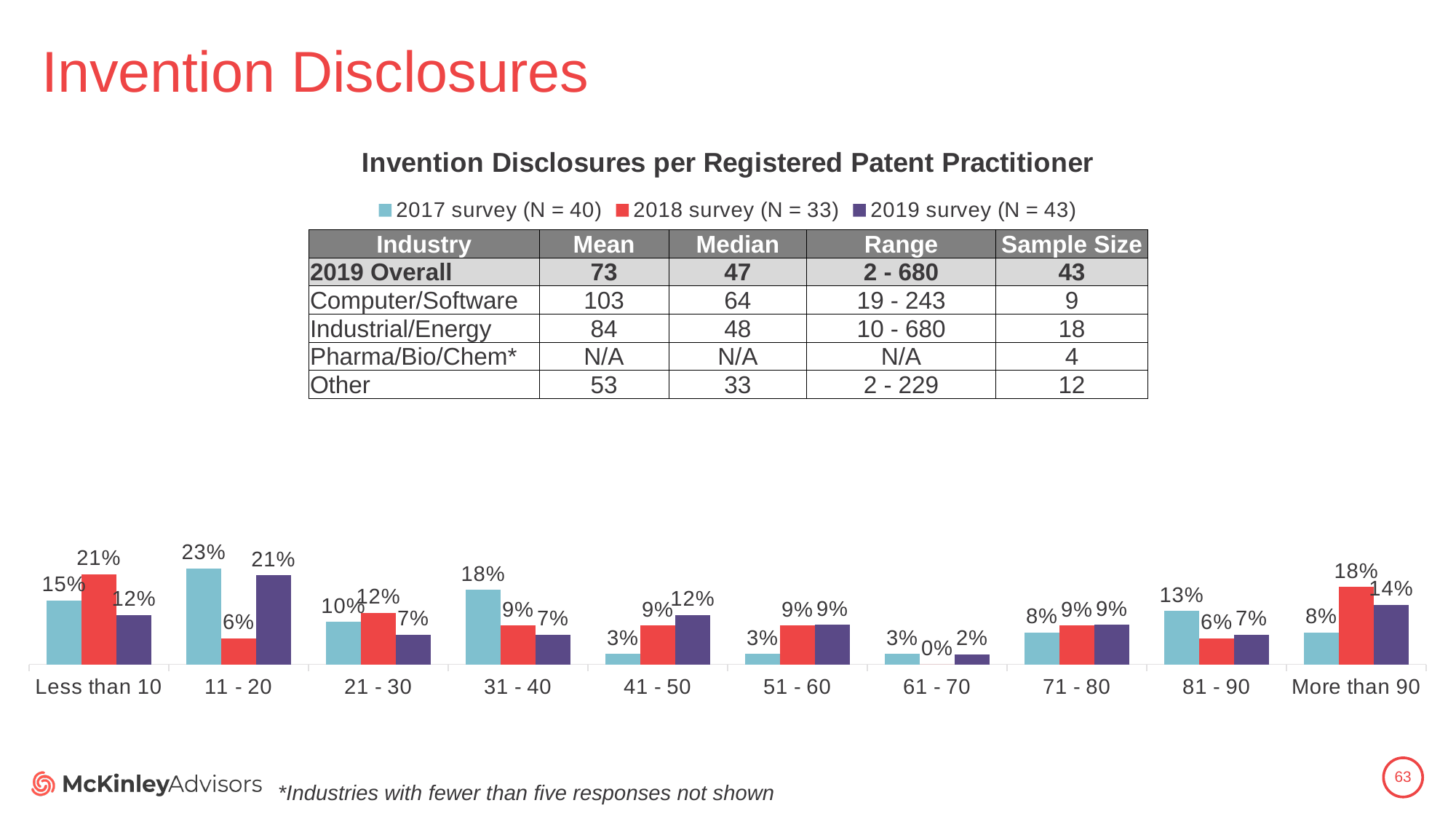
What is the value for the 2018 survey in the "More than 90" category? 18% In the "31 - 40" category, which is larger: the 2017 survey value or the 2018 survey value? 2017 survey What is the difference between the 2018 survey and 2019 survey values in the "Less than 10" category? 9% Which category has the lowest value for the 2018 survey? 61 - 70 What is the difference between the 2017 survey and 2018 survey values in the "11 - 20" category? 17% What is the value for the 2019 survey in the "41 - 50" category? 12% What kind of chart is shown on the slide? Bar chart How many series does the chart legend list? 3 Which category has the highest value for the 2017 survey? 11 - 20 In the "More than 90" category, which is larger: the 2017 survey value or the 2019 survey value? 2019 survey How many categories are shown on the x axis of the chart? 10 What is the value for the 2017 survey in the "11 - 20" category? 23%